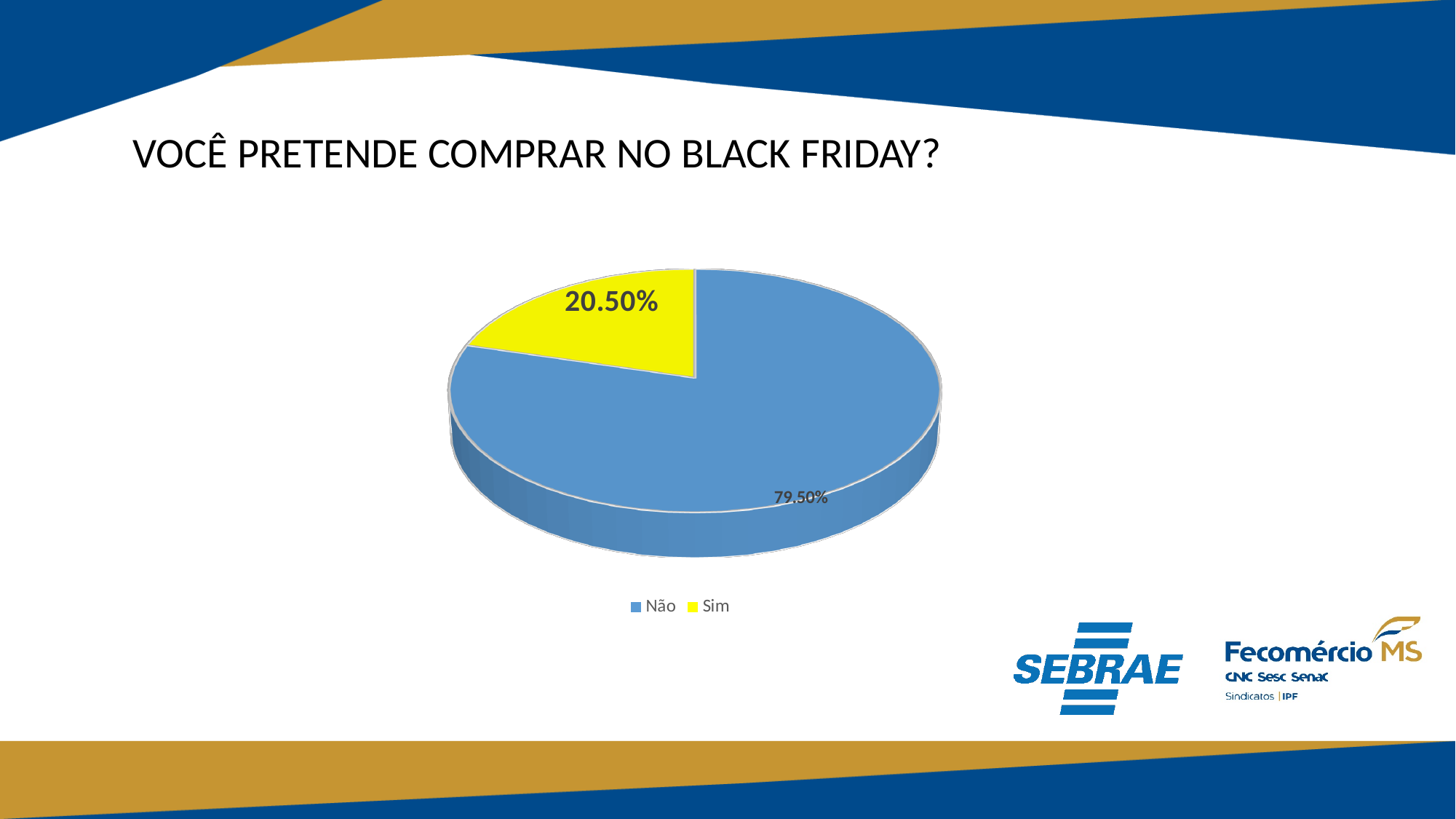
How many slices does the pie chart have? 2 Which response has the smallest share of the pie? Sim What share of the pie does the "Sim" slice represent? 20.50% What colour is the "Sim" slice? Yellow What percentage of respondents answered "Sim"? 20.50% What percentage of respondents answered "Não"? 79.50% What kind of chart is shown on the slide? Pie chart Which response has the largest share of the pie? Não What question does the slide title ask? VOCÊ PRETENDE COMPRAR NO BLACK FRIDAY? What is the difference in percentage points between the "Não" and "Sim" slices? 59 percentage points Which is larger, the share for "Sim" or the share for "Não"? Não